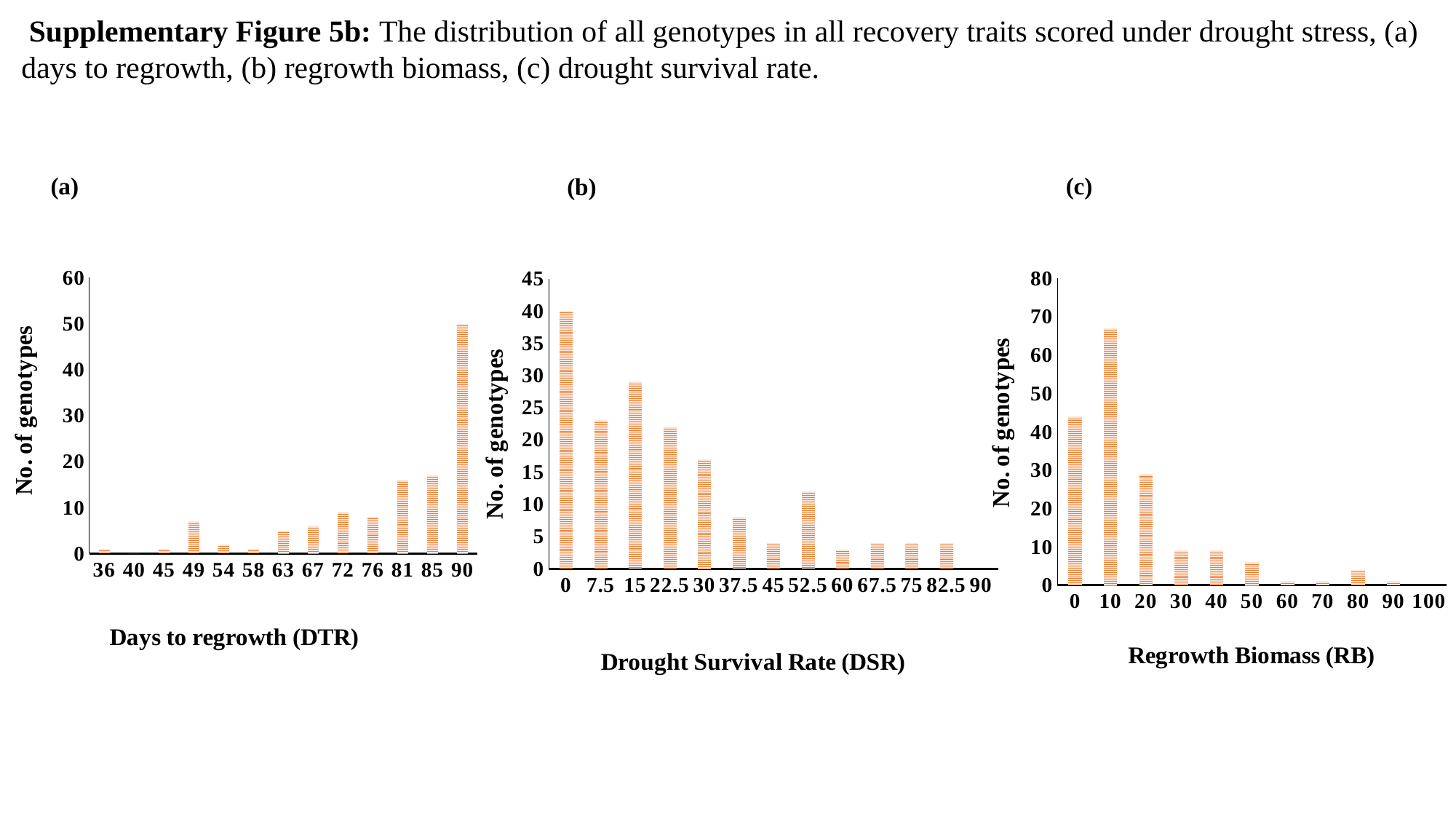
In chart (a), Days to regrowth (DTR), is the number of genotypes for 90 days greater or less than 40? greater In chart (b), Drought Survival Rate (DSR), which survival rate category has the highest number of genotypes? 0 In chart (c), Regrowth Biomass (RB), is the number of genotypes for a regrowth biomass of 10 greater or less than 60? greater In chart (b), Drought Survival Rate (DSR), is the number of genotypes for a survival rate of 52.5 greater or less than 10? greater In chart (c), Regrowth Biomass (RB), which regrowth biomass category has the highest number of genotypes? 10 In chart (a), Days to regrowth (DTR), which has more genotypes, 49 days or 54 days? 49 What kind of chart is chart (a), Days to regrowth (DTR)? bar chart In chart (c), Regrowth Biomass (RB), how many regrowth biomass categories are shown on the x axis? 11 In chart (a), Days to regrowth (DTR), which days-to-regrowth category has the highest number of genotypes? 90 In chart (b), Drought Survival Rate (DSR), which has more genotypes, a survival rate of 15 or 22.5? 15 In chart (a), Days to regrowth (DTR), how many days-to-regrowth categories are shown on the x axis? 13